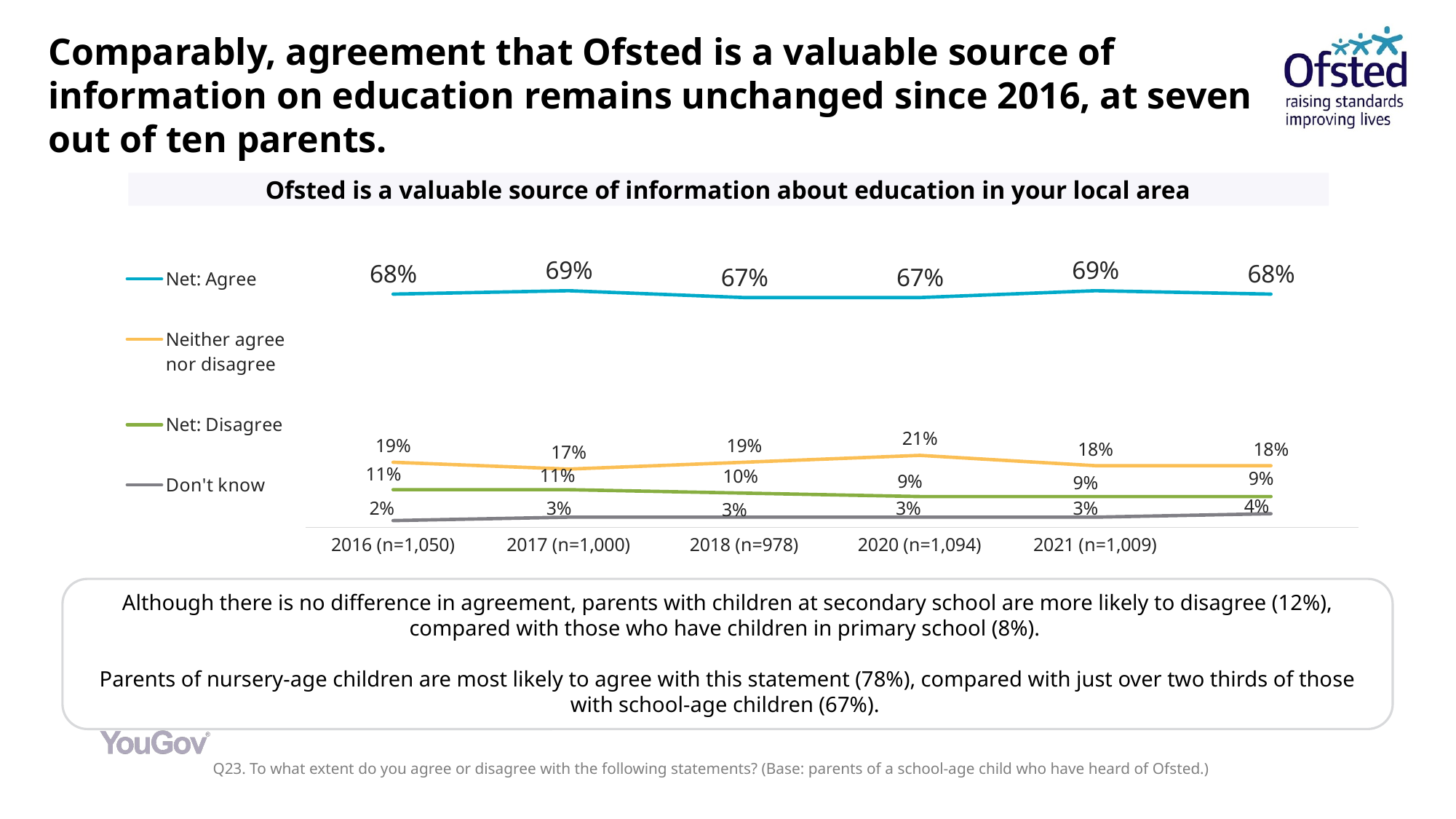
What is the Neither agree nor disagree value for 2020 (n=1,094)? 21% What is the title of the chart? Ofsted is a valuable source of information about education in your local area What is the Net: Agree value for 2016 (n=1,050)? 68% What is the Net: Agree value for 2021 (n=1,009)? 69% Which is larger, the Neither agree nor disagree value in 2016 (n=1,050) or in 2017 (n=1,000)? 2016 (n=1,050) How many series does the legend list? 4 What is the Don't know value for 2016 (n=1,050)? 2% What is the Net: Disagree value for 2018 (n=978)? 10% What is the difference between the Net: Agree and Net: Disagree values in 2017 (n=1,000)? 58 percentage points What kind of chart is shown on the slide? Line chart Does the Net: Disagree value rise or fall from 2016 (n=1,050) to 2021 (n=1,009)? Fall In which labelled year is the Neither agree nor disagree value highest? 2020 (n=1,094)